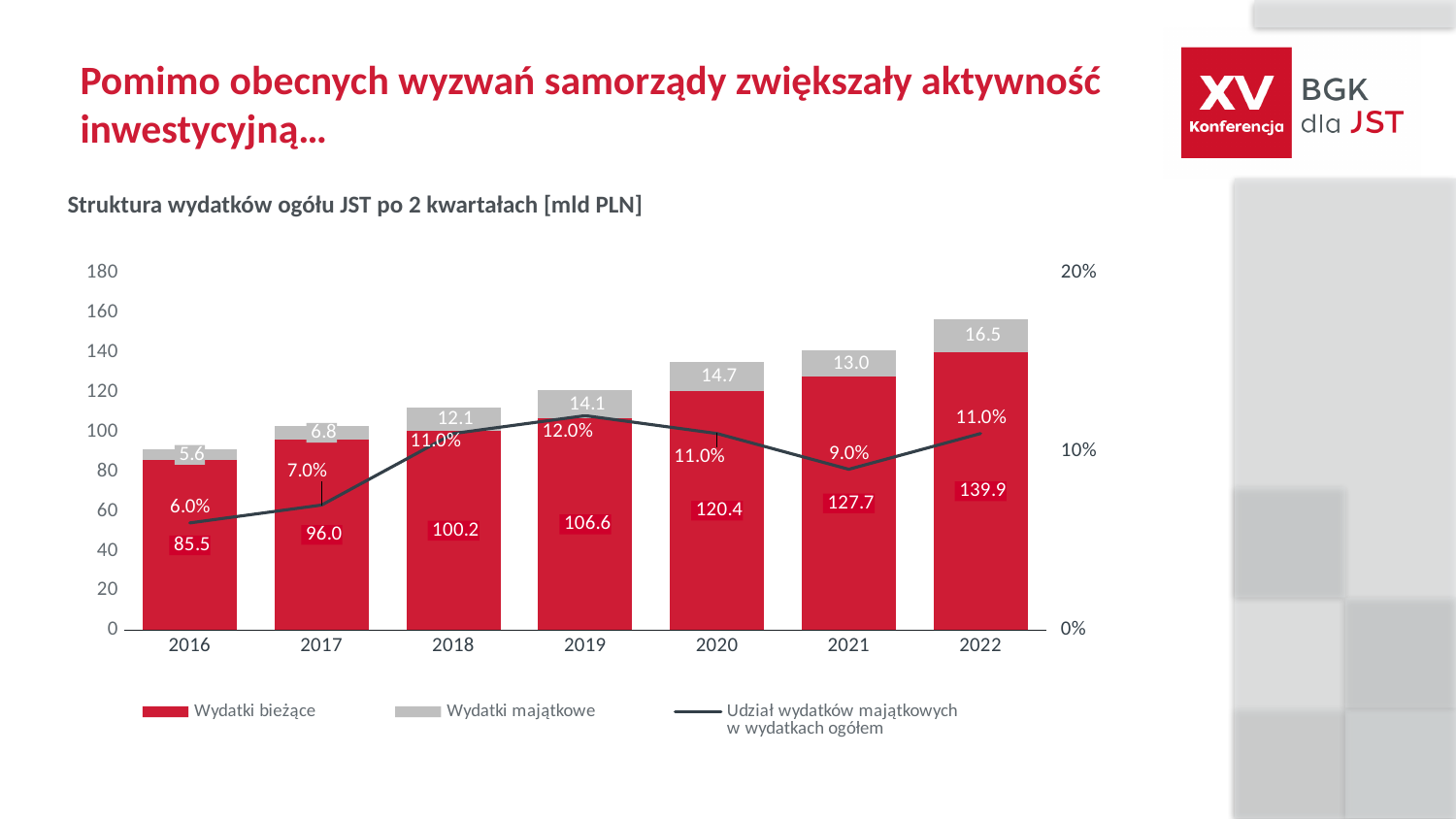
What is the value of Wydatki majątkowe for 2019? 14.1 How many series does the legend list? 3 How many years are shown on the x axis? 7 Which year has the lowest value of Wydatki bieżące? 2016 Which year has the highest value of Wydatki majątkowe? 2022 Do the values of Wydatki bieżące rise or fall from 2016 to 2022? Rise What is the total of the stacked bar for 2016? 91.1 Which is larger: Wydatki majątkowe in 2020 or in 2021? 2020 What kind of chart is shown on the slide? Stacked bar chart with a line What is the difference between Wydatki bieżące in 2022 and in 2021? 12.2 What is the Udział wydatków majątkowych w wydatkach ogółem for 2017? 7.0% What is the value of Wydatki bieżące for 2022? 139.9